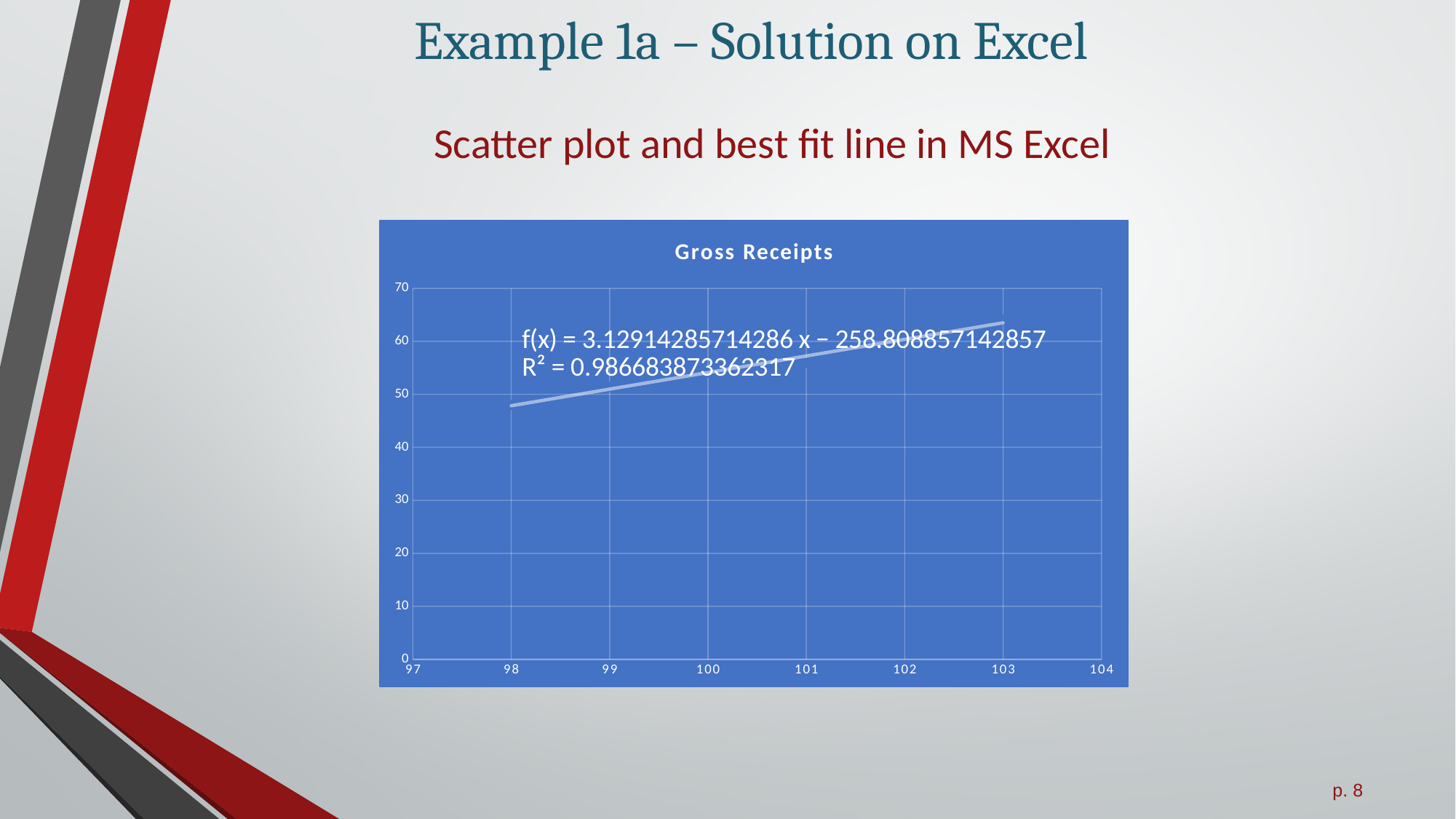
Does the best fit line rise or fall as x increases from 98 to 103? rises What kind of chart is shown on the slide? scatter plot with a best fit line Is the value of the best fit line at x = 98 greater or less than 50? less What is the lowest value shown on the horizontal axis? 97 Is the value of the best fit line at x = 103 greater or less than 60? greater What is the intercept (constant term) of the best fit line f(x) printed on the chart? −258.808857142857 What is the highest value shown on the horizontal axis? 104 What is the slope of the best fit line f(x) printed on the chart? 3.12914285714286 What is the R² value printed on the chart? 0.986683873362317 What is the title of the chart? Gross Receipts What is the highest value shown on the vertical axis? 70